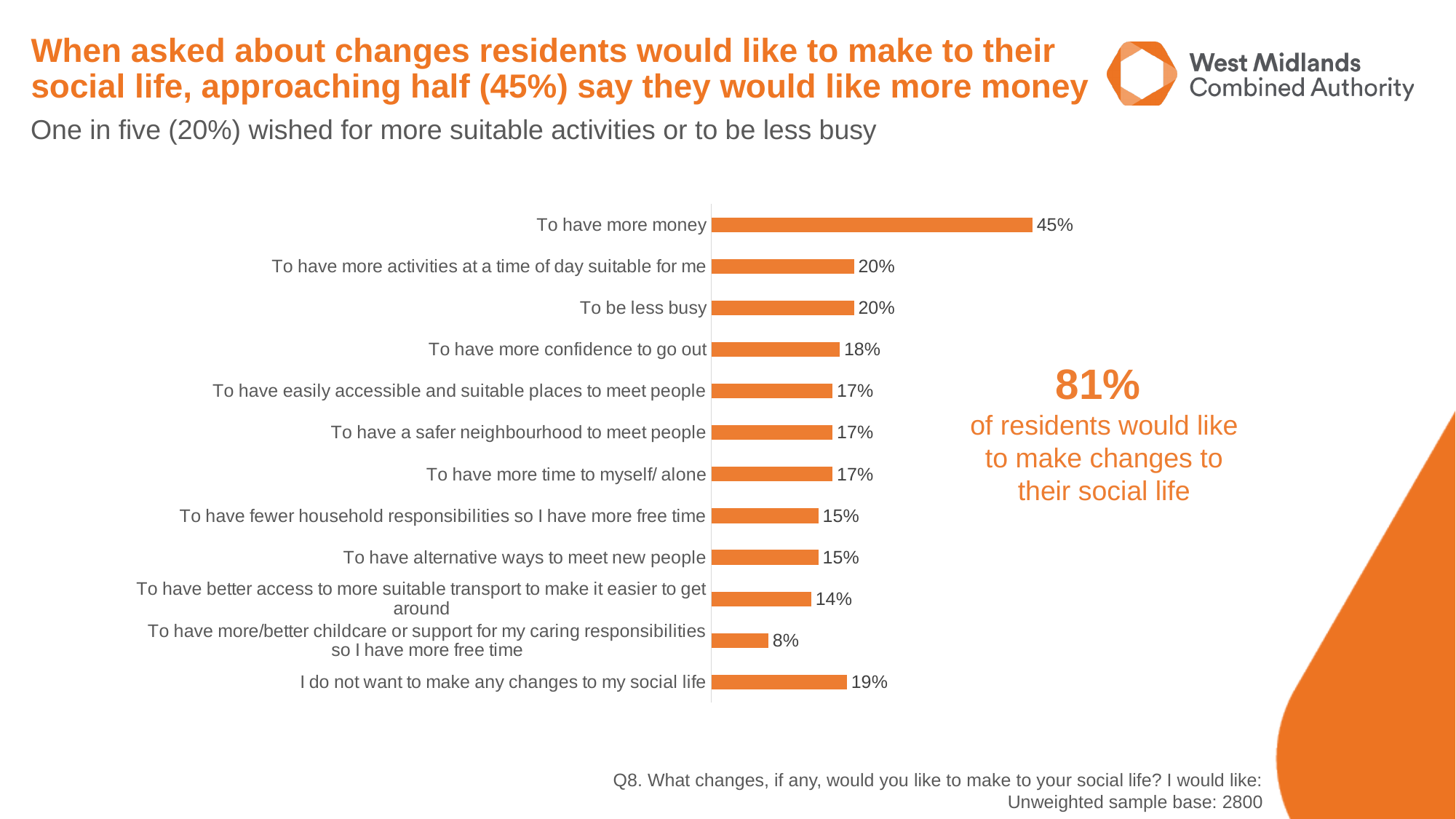
What percentage of residents said they do not want to make any changes to their social life? 19% How many categories are shown in the chart? 12 What percentage of residents said they would like more/better childcare or support for their caring responsibilities? 8% What kind of chart is shown on the slide? Bar chart What percentage of residents said they would like to have more confidence to go out? 18% Which is larger: the value for 'To have more time to myself/ alone' or the value for 'To have alternative ways to meet new people'? To have more time to myself/ alone What is the difference in percentage points between 'To have more money' and 'To be less busy'? 25 What percentage of residents said they would like to have more money? 45% According to the slide, what percentage of residents would like to make changes to their social life? 81% What is the difference in percentage points between 'To have more confidence to go out' and 'To have better access to more suitable transport to make it easier to get around'? 4 Which change has the highest percentage of residents? To have more money Which change has the lowest percentage of residents? To have more/better childcare or support for my caring responsibilities so I have more free time